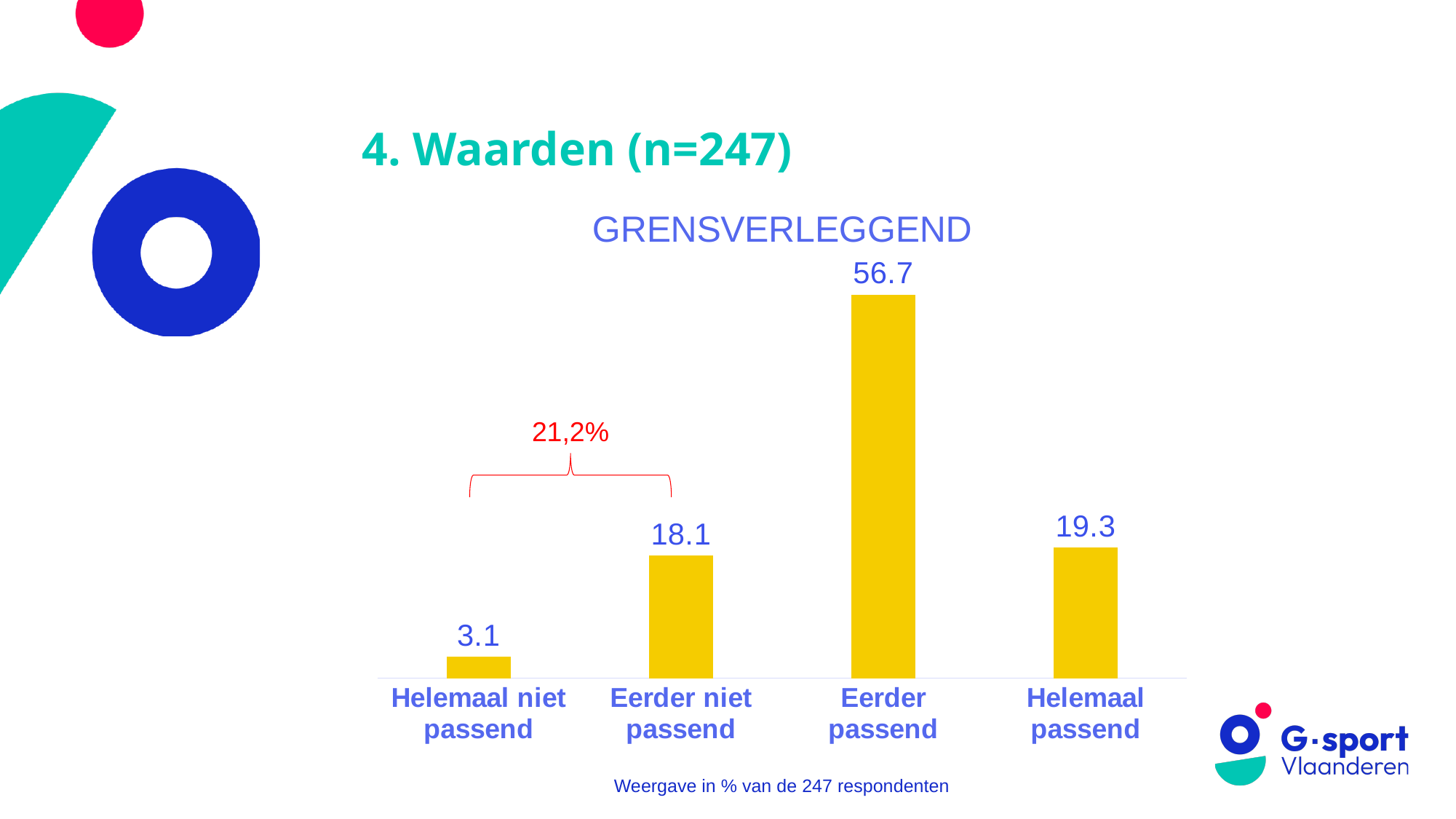
Which is larger in the GRENSVERLEGGEND chart: the value for 'Eerder niet passend' or 'Helemaal passend'? Helemaal passend What kind of chart is the GRENSVERLEGGEND chart? Bar chart What is the value for 'Helemaal niet passend' in the GRENSVERLEGGEND chart? 3.1 Which category has the highest value in the GRENSVERLEGGEND chart? Eerder passend What is the difference between the values for 'Eerder passend' and 'Helemaal passend' in the GRENSVERLEGGEND chart? 37.4 Which category has the lowest value in the GRENSVERLEGGEND chart? Helemaal niet passend What percentage is shown in red above the bracket spanning the first two bars of the GRENSVERLEGGEND chart? 21,2% What is the value for 'Eerder passend' in the GRENSVERLEGGEND chart? 56.7 What is the difference between the values for 'Helemaal passend' and 'Eerder niet passend' in the GRENSVERLEGGEND chart? 1.2 What is the value for 'Helemaal passend' in the GRENSVERLEGGEND chart? 19.3 How many categories are shown in the GRENSVERLEGGEND chart? 4 What is the value for 'Eerder niet passend' in the GRENSVERLEGGEND chart? 18.1